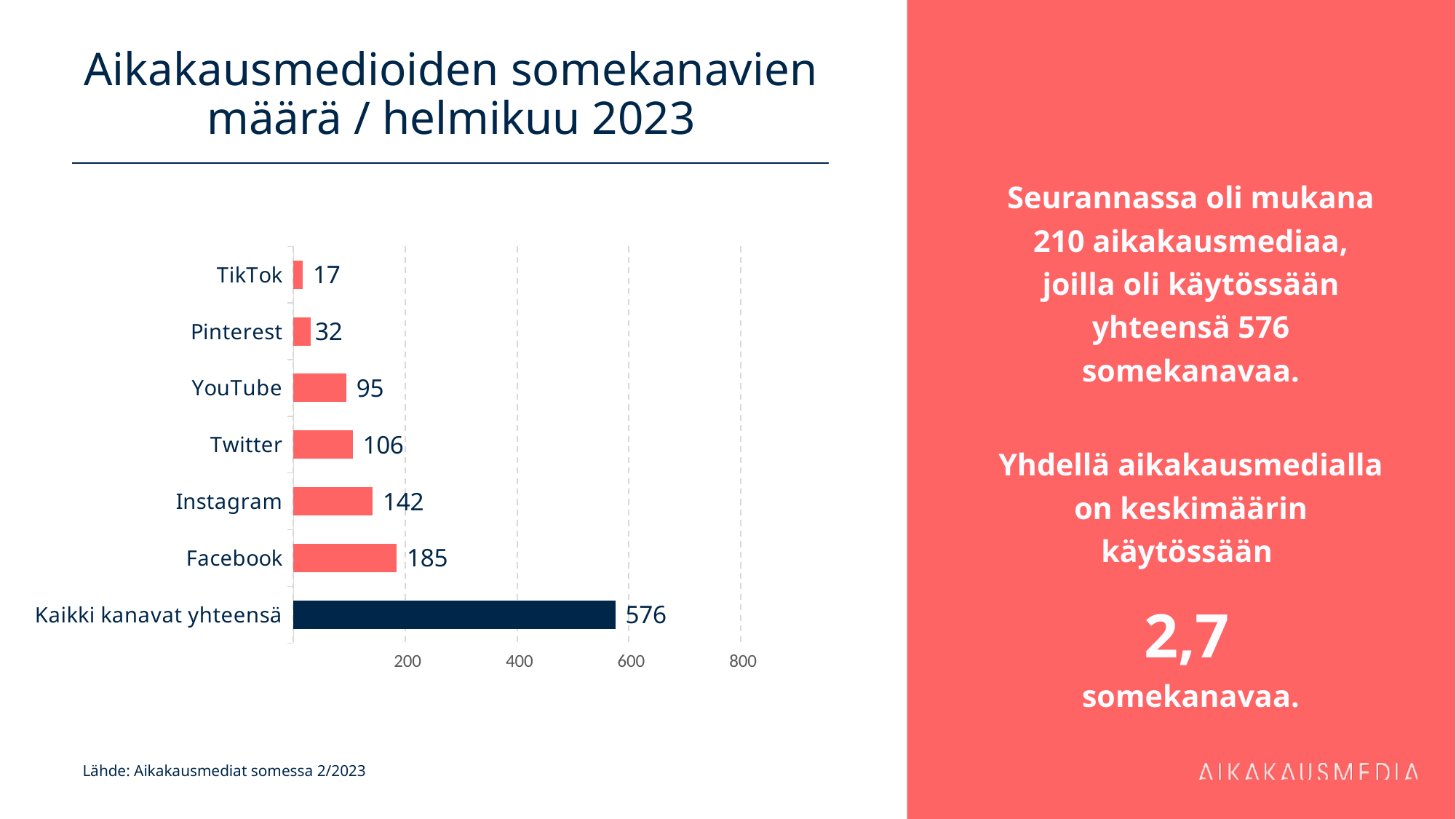
What is the difference between the values for Facebook and Instagram? 43 What is the value for TikTok? 17 Which is larger, the value for Pinterest or the value for YouTube? YouTube Which category has the lowest value? TikTok What is the value for Facebook? 185 Which individual social media channel has the highest number? Facebook What kind of chart is shown on the slide? bar chart What is the value for Kaikki kanavat yhteensä? 576 How many categories are shown in the chart? 7 What is the value for Instagram? 142 What is the difference between the values for Twitter and YouTube? 11 Is the value for Kaikki kanavat yhteensä greater or less than 400? greater